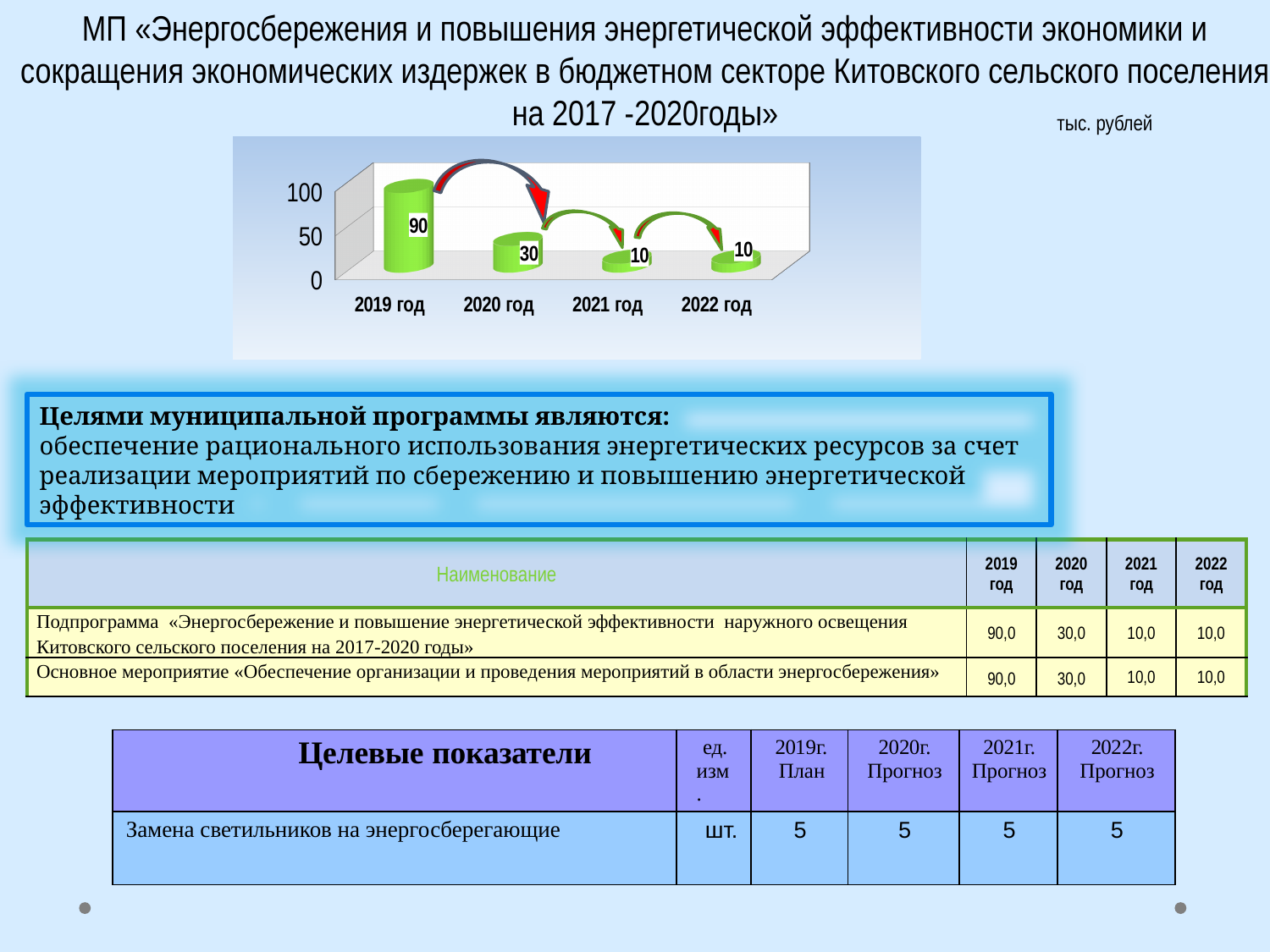
What is the difference between the values for 2020 год and 2021 год? 20 Which year has the highest value on the chart? 2019 год Do the values on the chart rise or fall from 2019 год to 2022 год? fall What kind of chart is shown on the slide? bar chart What is the difference between the values for 2019 год and 2020 год? 60 How many years are shown on the x axis of the chart? 4 What is the value shown for 2019 год on the chart? 90 What is the value shown for 2021 год on the chart? 10 What is the value shown for 2020 год on the chart? 30 Is the value for 2019 год greater or less than 50? greater Which is larger, the value for 2019 год or the value for 2020 год? 2019 год What is the value shown for 2022 год on the chart? 10